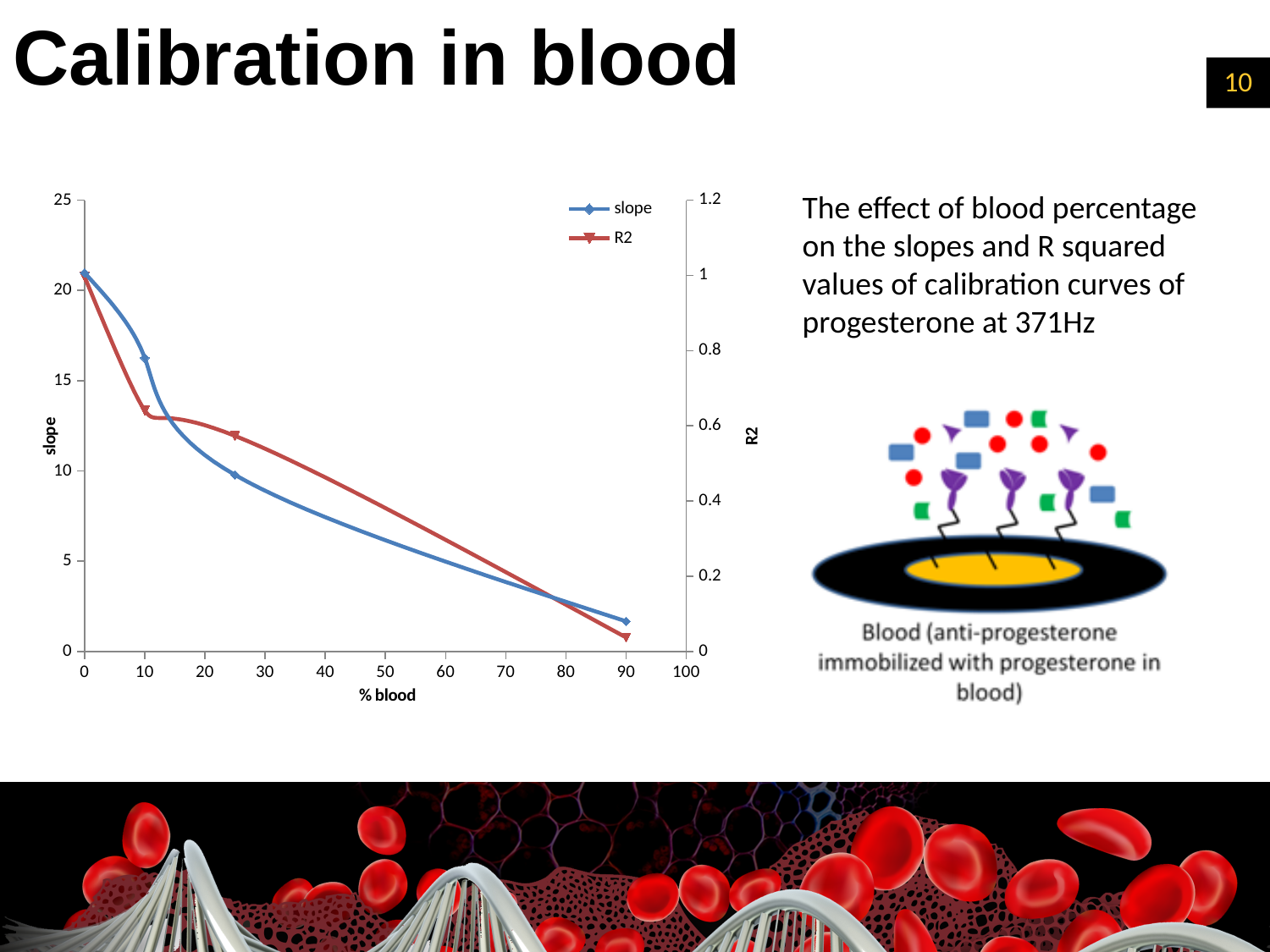
How many data points are plotted for the slope series? 4 Is the slope value at 0% blood greater or less than 20? greater What kind of chart is shown on the slide? line chart How many series does the chart legend list? 2 Does the slope series rise or fall as % blood increases? fall Is the R2 value at 90% blood greater or less than 0.2? less What are the two series named in the chart legend? slope and R2 What is the title of the x axis of the chart? % blood Is the slope value at 90% blood greater or less than 5? less At which % blood value is the slope lowest? 90 Does the R2 series rise or fall as % blood increases? fall At which % blood value is the slope highest? 0